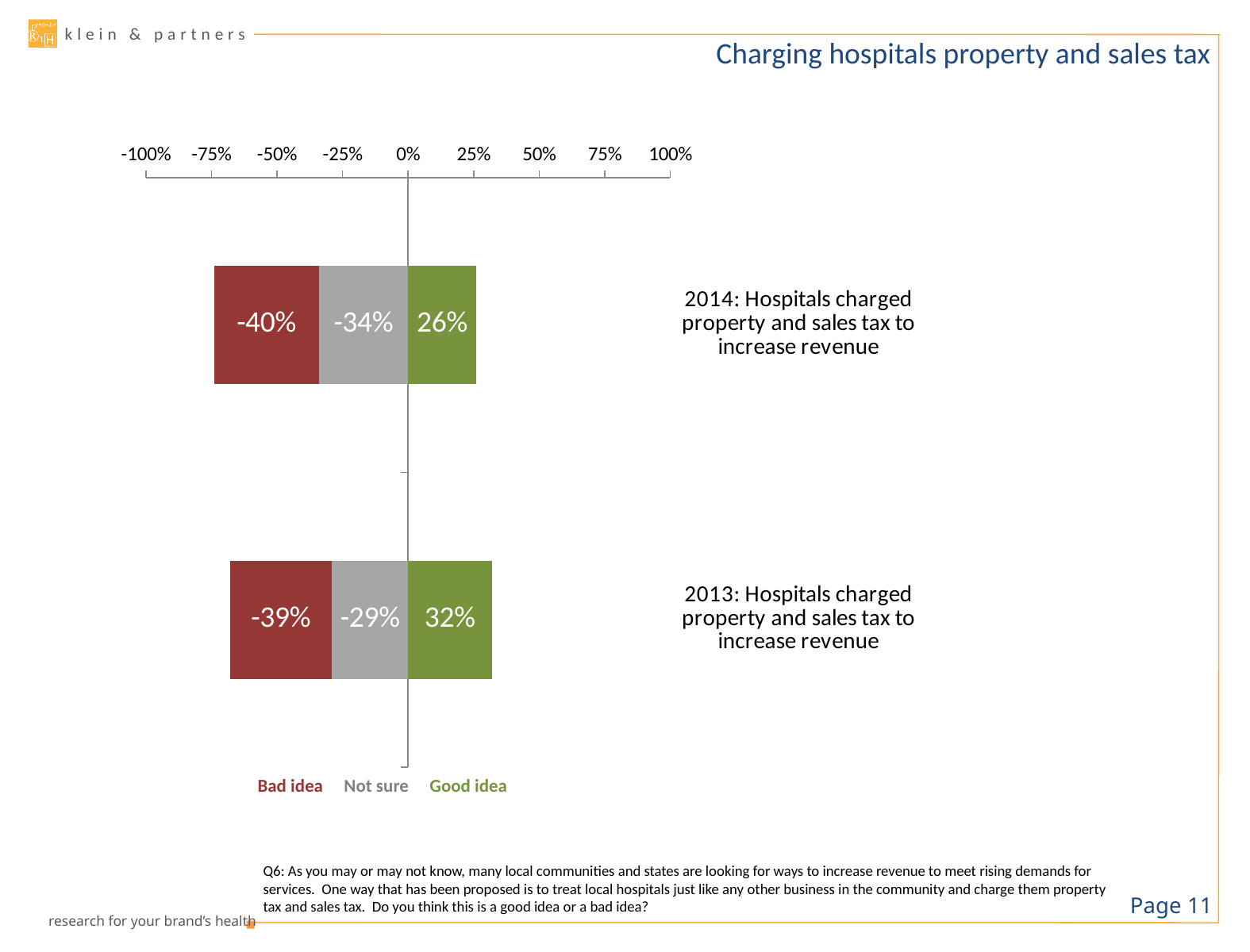
What is the Not sure value for 2013: Hospitals charged property and sales tax to increase revenue? -29% What is the Not sure value for 2014: Hospitals charged property and sales tax to increase revenue? -34% What is the difference between the Not sure values for 2014 and 2013? 5 percentage points How many categories (years) are shown in the chart? 2 How many series does the legend list? 3 What kind of chart is shown on the slide? Stacked bar chart What is the Bad idea value for 2014: Hospitals charged property and sales tax to increase revenue? -40% Which year has the higher Good idea value, 2014 or 2013? 2013 What is the Good idea value for 2013: Hospitals charged property and sales tax to increase revenue? 32% Which series is shown in green? Good idea What is the title of the chart? Charging hospitals property and sales tax What is the difference between the Good idea values for 2013 and 2014? 6 percentage points